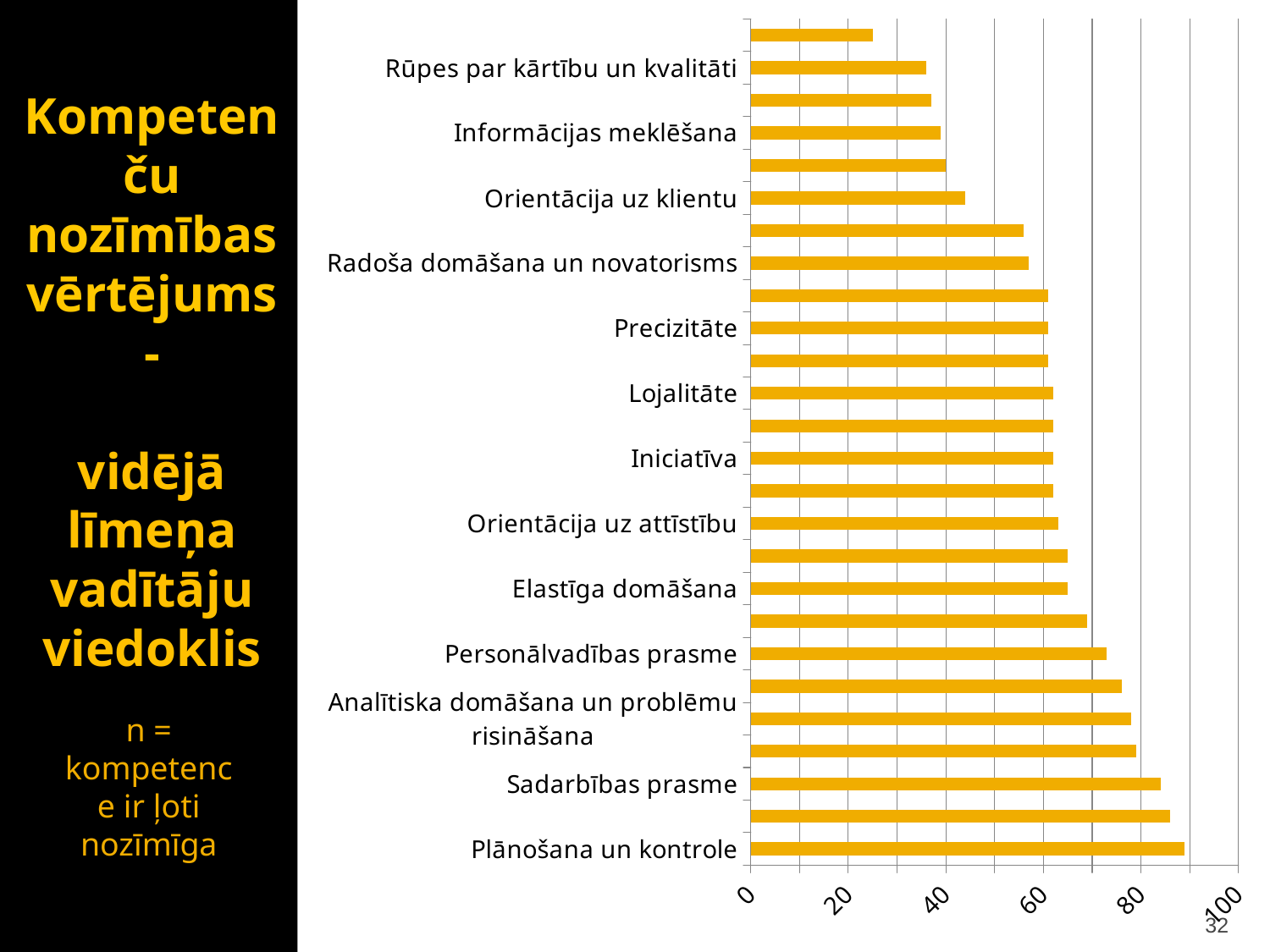
What is the highest value shown on the horizontal axis? 100 Is the value for Rūpes par kārtību un kvalitāti greater or less than 40? less Which labelled competence has the highest value? Plānošana un kontrole Is the value for Orientācija uz klientu greater or less than 40? greater Is the value for Sadarbības prasme greater or less than 80? greater What kind of chart is shown on the slide? bar chart Which is larger, the value for Plānošana un kontrole or the value for Sadarbības prasme? Plānošana un kontrole Which is larger, the value for Orientācija uz klientu or the value for Radoša domāšana un novatorisms? Radoša domāšana un novatorisms